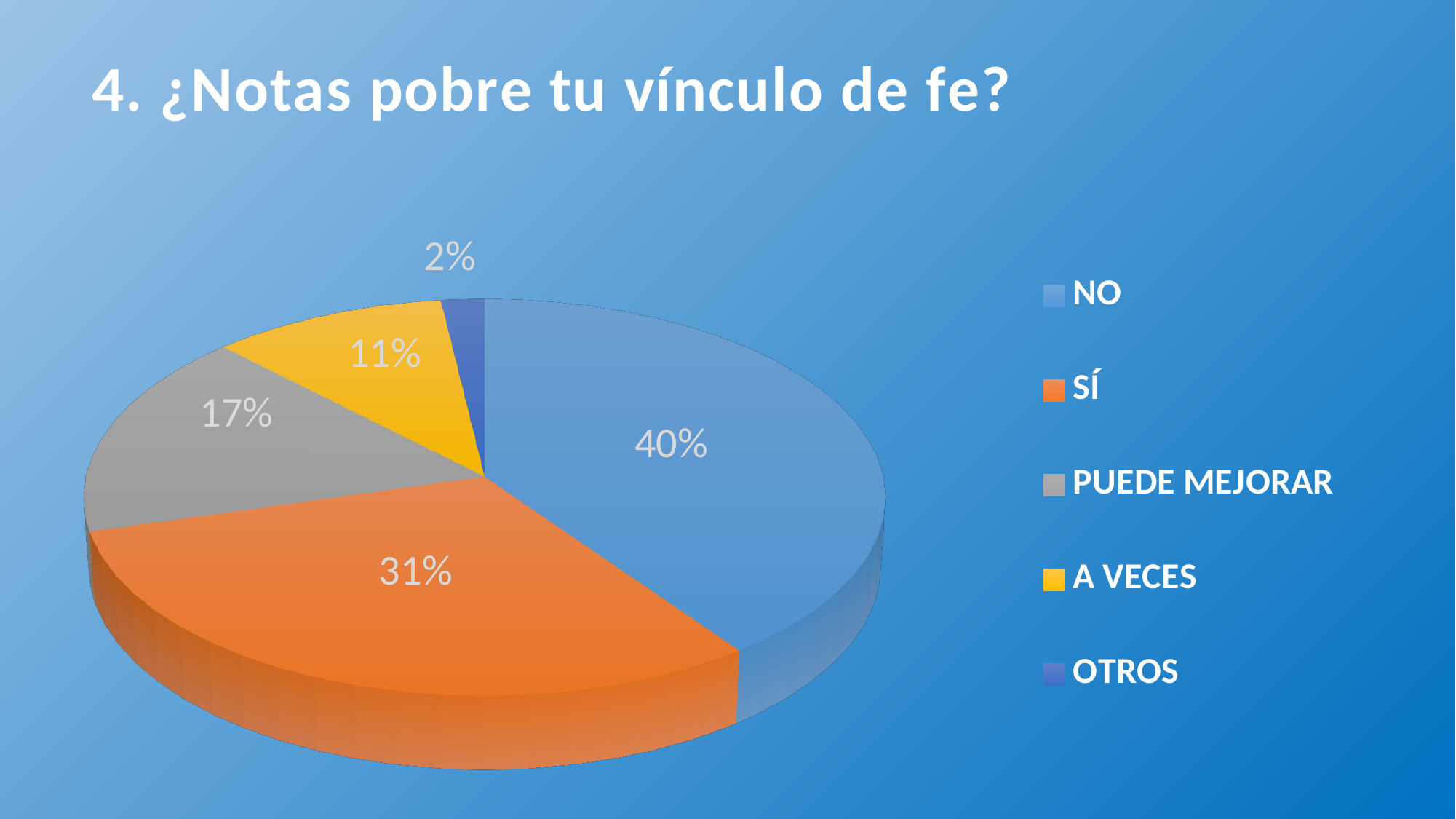
What percentage of the pie chart is labelled NO? 40% What type of chart is shown on the slide? Pie chart Which slice is larger, PUEDE MEJORAR or A VECES? PUEDE MEJORAR What percentage of the pie chart is labelled A VECES? 11% Which category has the smallest slice of the pie chart? OTROS Which category has the largest slice of the pie chart? NO What colour is the slice for A VECES? Yellow What percentage of the pie chart is labelled SÍ? 31% What is the difference in percentage points between the NO slice and the SÍ slice? 9 What percentage of the pie chart is labelled PUEDE MEJORAR? 17% What percentage of the pie chart is labelled OTROS? 2% How many categories does the pie chart show? 5